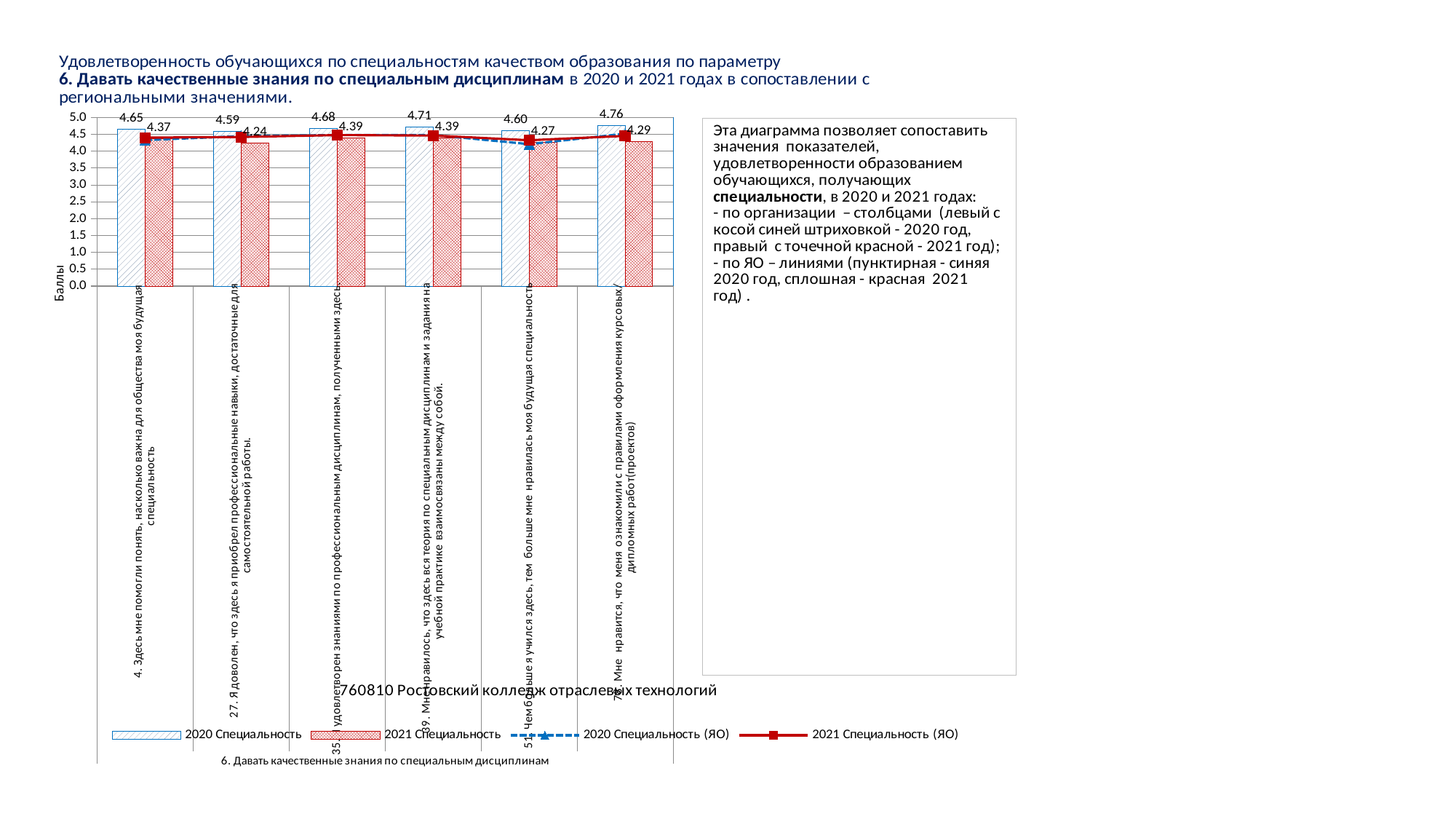
What is the label of the vertical axis of the chart? Баллы What is the value of the 2021 Специальность bar for the category "27. Я доволен, что здесь я приобрел профессиональные навыки, достаточные для самостоятельной работы"? 4.24 Which category has the lowest 2021 Специальность value? 27. Я доволен, что здесь я приобрел профессиональные навыки, достаточные для самостоятельной работы How many series does the chart legend list? 4 What is the value of the 2020 Специальность bar for the category "4. Здесь мне помогли понять, насколько важна для общества моя будущая специальность"? 4.65 How many categories are shown on the x axis of the chart? 6 Is the 2021 Специальность value for the category "51. Чем больше я учился здесь, тем больше мне нравилась моя будущая специальность" greater or less than 4.0? greater What kind of chart is used to show the 2020 Специальность and 2021 Специальность values? Bar chart What is the difference between the 2020 Специальность and 2021 Специальность values for the category "4. Здесь мне помогли понять, насколько важна для общества моя будущая специальность"? 0.28 Which category has the highest 2020 Специальность value? Мне нравится, что меня ознакомили с правилами оформления курсовых/дипломных работ (проектов) For the category about "правилами оформления курсовых/дипломных работ", which is larger: the 2020 Специальность value or the 2021 Специальность value? 2020 Специальность What is the value of the 2020 Специальность bar for the category "51. Чем больше я учился здесь, тем больше мне нравилась моя будущая специальность"? 4.60